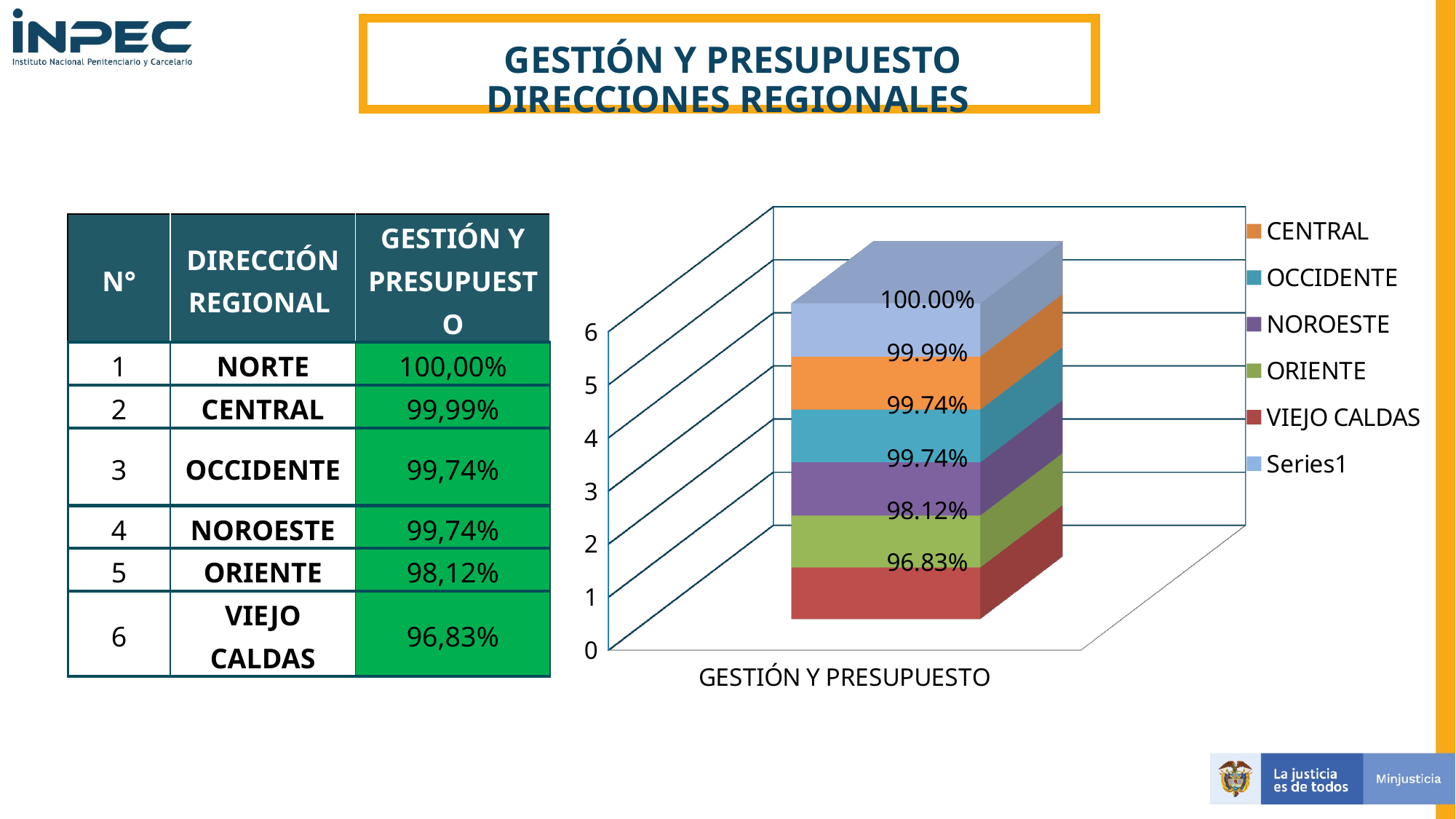
What is the difference between the values for ORIENTE and VIEJO CALDAS? 1.29% What is the value shown for OCCIDENTE in the chart? 99.74% How many series does the chart legend list? 6 What is the value shown for CENTRAL in the chart? 99.99% What kind of chart is shown on the slide? Bar chart Which series has the lowest value in the chart? VIEJO CALDAS What is the value shown for ORIENTE in the chart? 98.12% What is the category label shown on the x axis of the chart? GESTIÓN Y PRESUPUESTO What colour is the VIEJO CALDAS segment in the chart? Red What is the difference between the values for CENTRAL and OCCIDENTE? 0.25% What is the value shown for VIEJO CALDAS in the chart? 96.83% Which is larger, the value for NOROESTE or the value for ORIENTE? NOROESTE